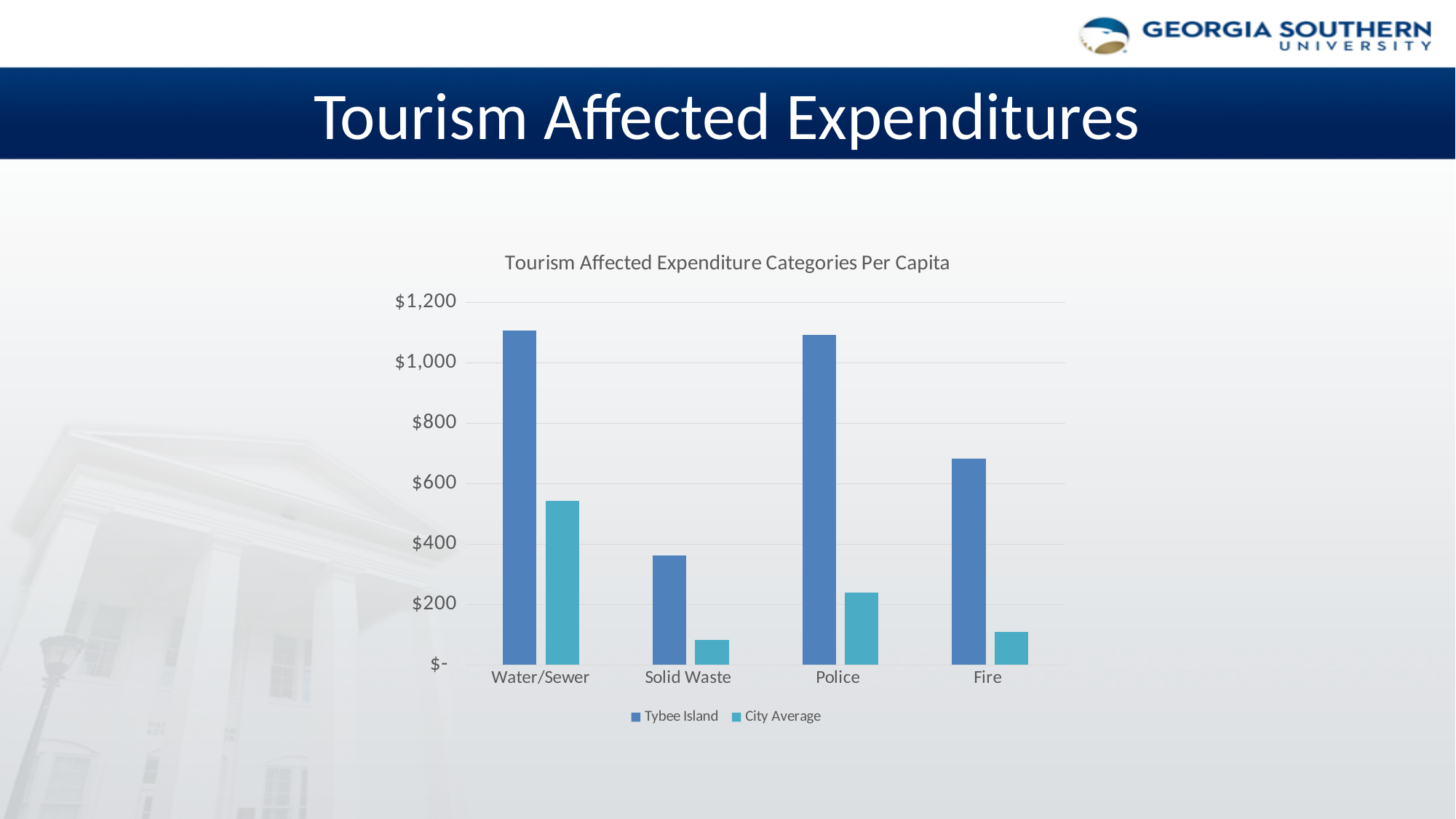
What kind of chart is shown on the slide? bar chart Which category has the lowest Tybee Island value? Solid Waste How many expenditure categories are shown on the x axis? 4 Is the Tybee Island value for Fire greater or less than $600? greater What is the title of the chart? Tourism Affected Expenditure Categories Per Capita Which category has the highest City Average value? Water/Sewer For Police, which is larger: the Tybee Island value or the City Average value? Tybee Island Is the City Average value for Water/Sewer greater or less than $600? less How many series does the legend list? 2 Is the Tybee Island value for Solid Waste greater or less than $400? less Which series is shown in the darker blue bars? Tybee Island